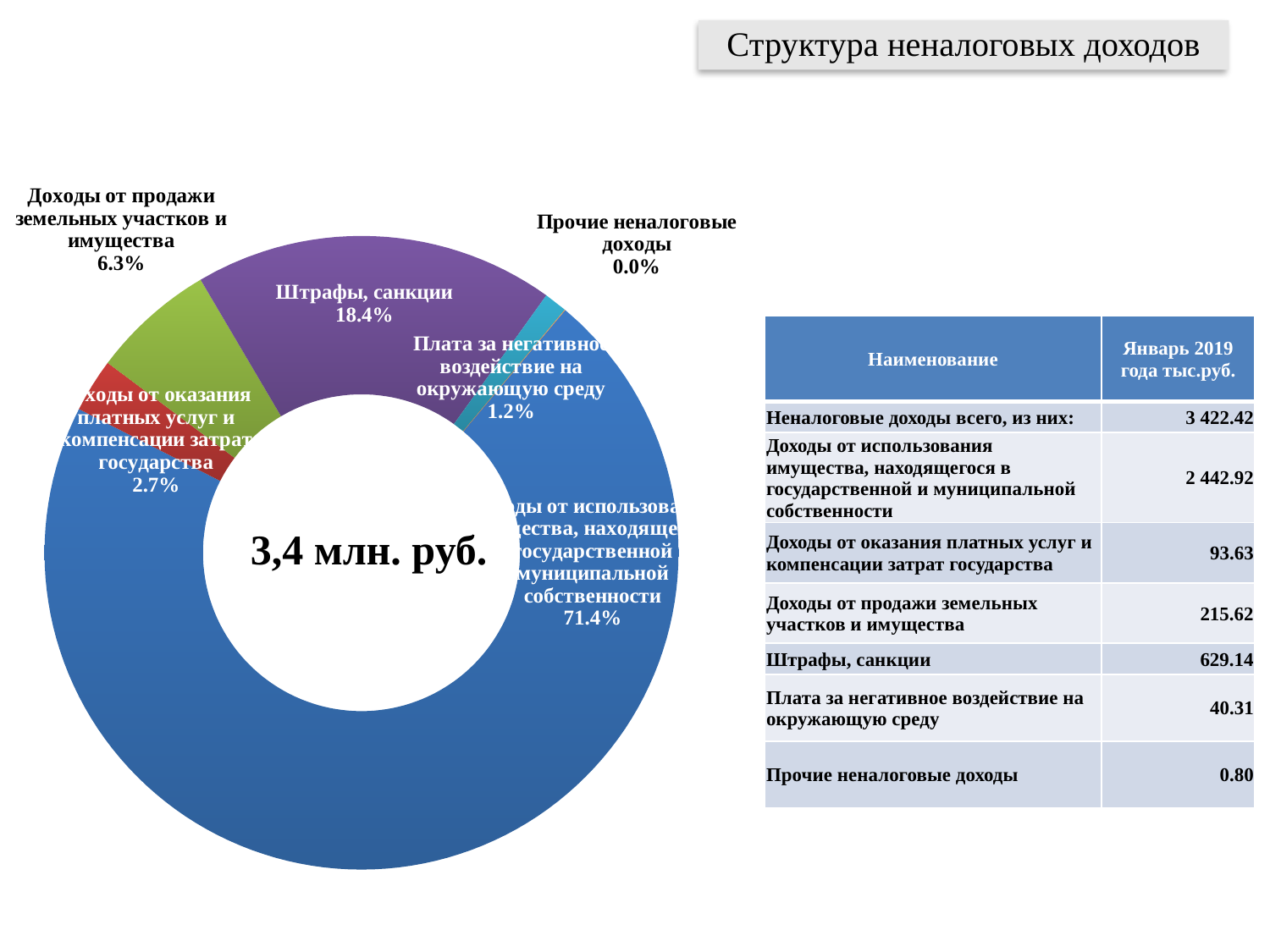
What kind of chart is shown on the slide? Pie (donut) chart What share of the chart does "Штрафы, санкции" have? 18.4% What total amount is printed in the centre of the chart? 3,4 млн. руб. Which category has the smallest share of the chart? Прочие неналоговые доходы How many categories (slices) does the chart show? 6 What share of the chart does "Прочие неналоговые доходы" have? 0.0% What share of the chart does "Доходы от продажи земельных участков и имущества" have? 6.3% What share of the chart does "Доходы от оказания платных услуг и компенсации затрат государства" have? 2.7% What is the difference in percentage points between the share of "Штрафы, санкции" and the share of "Доходы от продажи земельных участков и имущества"? 12.1 percentage points Which category has the largest share of the chart? Доходы от использования имущества, находящегося в государственной и муниципальной собственности Which has a larger share: "Доходы от оказания платных услуг и компенсации затрат государства" or "Плата за негативное воздействие на окружающую среду"? Доходы от оказания платных услуг и компенсации затрат государства What share of the chart does "Плата за негативное воздействие на окружающую среду" have? 1.2%